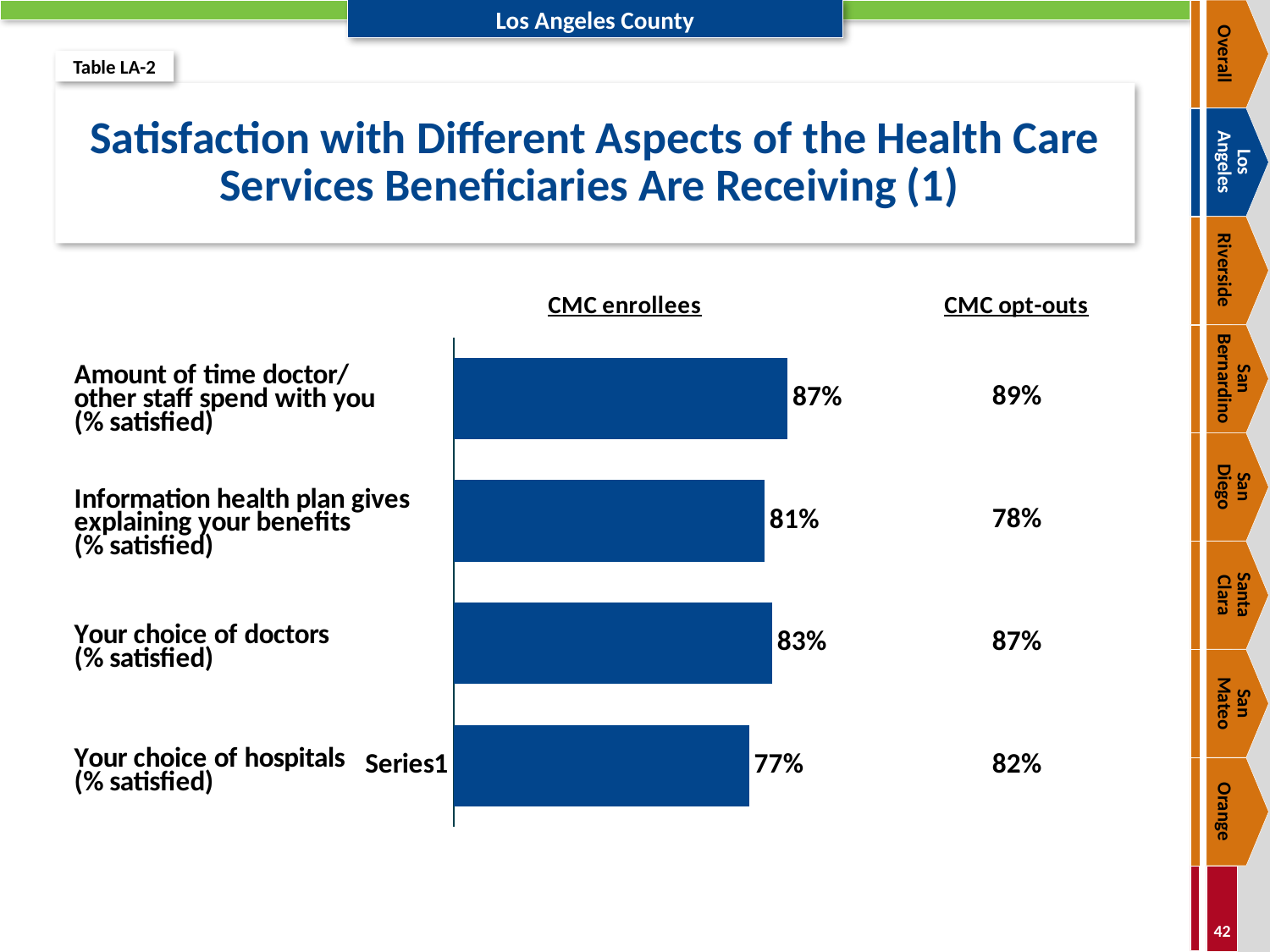
What type of chart is used to show the CMC enrollees satisfaction values? Bar chart How many aspects of health care services are plotted as bars in the chart? 4 What is the difference between the CMC enrollees satisfaction for 'Amount of time doctor/other staff spend with you' and 'Your choice of hospitals'? 10% What is the CMC enrollees value for 'Your choice of hospitals (% satisfied)'? 77% Which aspect has the lowest satisfaction among CMC enrollees? Your choice of hospitals What percentage of CMC enrollees are satisfied with the amount of time doctor/other staff spend with them? 87% What is the CMC enrollees value for 'Information health plan gives explaining your benefits (% satisfied)'? 81% For 'Your choice of hospitals (% satisfied)', which group has the higher value: CMC enrollees or CMC opt-outs? CMC opt-outs Which aspect has the highest satisfaction among CMC enrollees? Amount of time doctor/other staff spend with you What is the CMC opt-outs satisfaction value printed next to 'Your choice of doctors (% satisfied)'? 87% Among CMC enrollees, which has a higher satisfaction value: 'Your choice of doctors' or 'Information health plan gives explaining your benefits'? Your choice of doctors What series name label appears next to the bottom bar of the chart? Series1